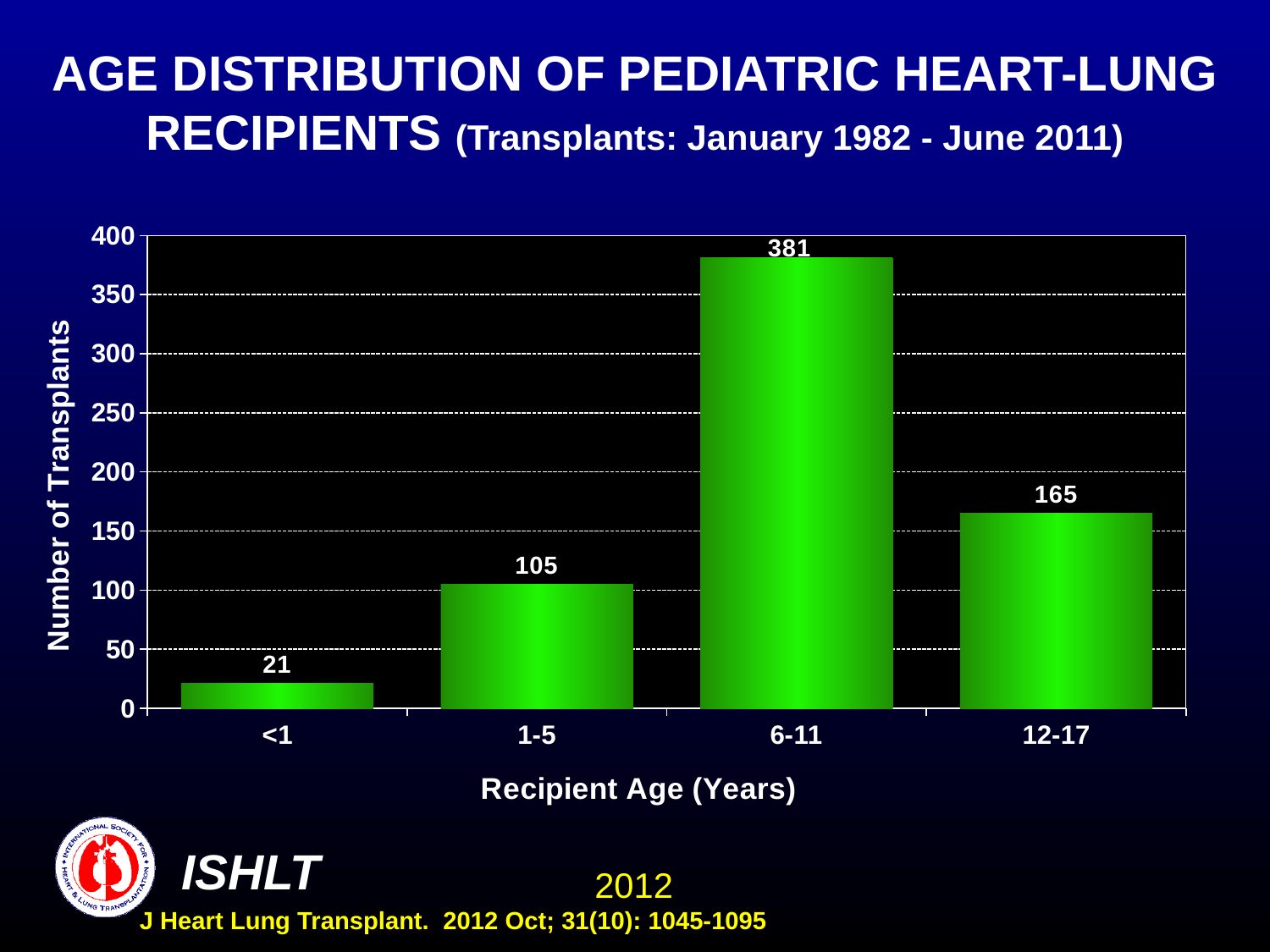
What is the number of transplants for recipients aged 12-17? 165 What is the label of the y-axis? Number of Transplants Is the number of transplants for the 12-17 age group greater or less than 150? greater Which age group has more transplants, 1-5 or 12-17? 12-17 What is the number of transplants for recipients aged 6-11? 381 What is the difference in number of transplants between the 6-11 and 12-17 age groups? 216 Which recipient age group has the lowest number of transplants? <1 What kind of chart is shown on the slide? Bar chart What is the number of transplants for recipients aged 1-5? 105 What is the number of transplants for recipients aged <1? 21 Which recipient age group has the highest number of transplants? 6-11 How many recipient age groups are shown on the chart? 4